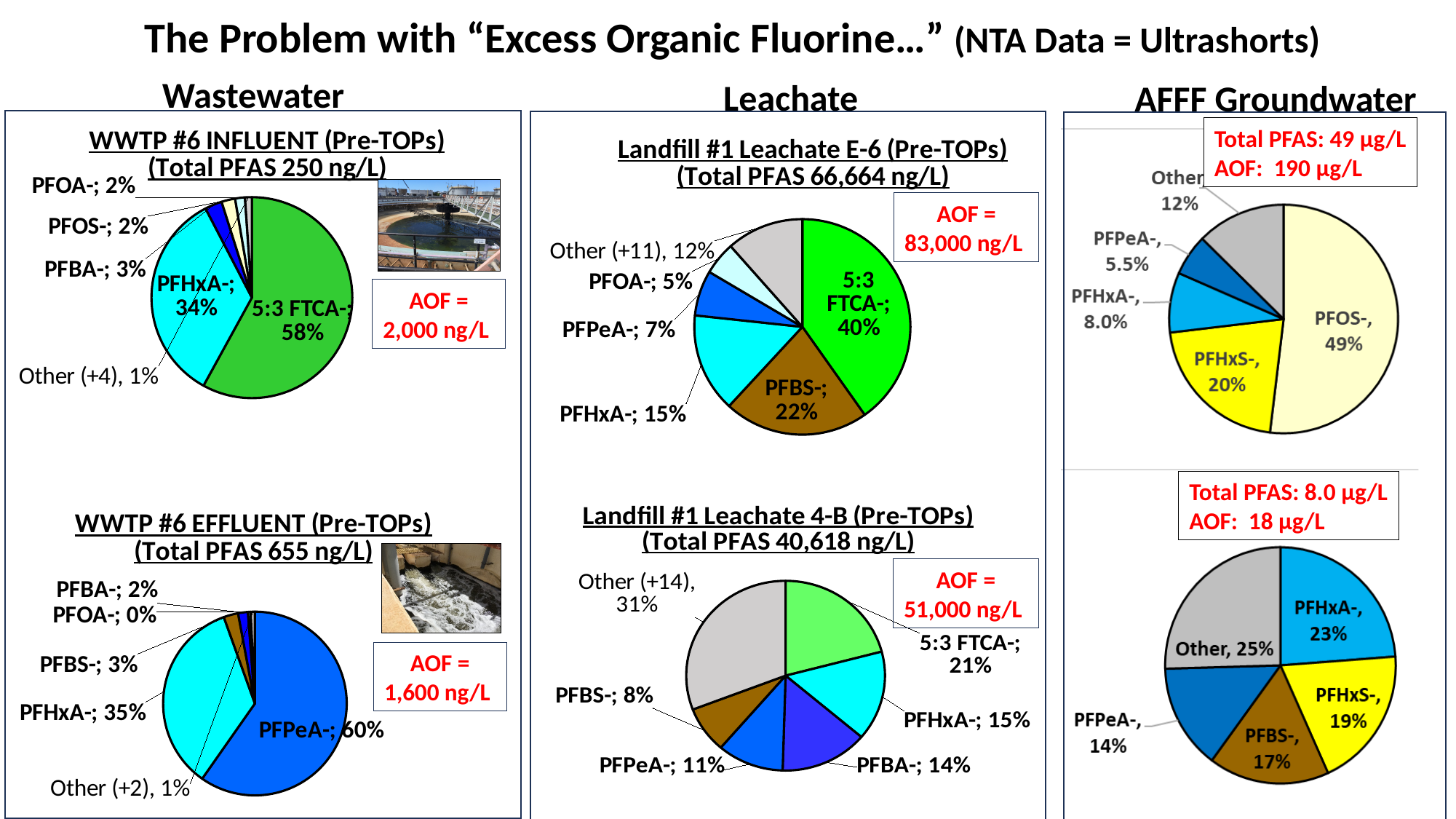
In the bottom AFFF Groundwater pie chart (Total PFAS: 8.0 µg/L), what share does PFHxS- have? 19% In the top AFFF Groundwater pie chart (Total PFAS: 49 µg/L), how many slices are there? 5 In the top AFFF Groundwater pie chart (Total PFAS: 49 µg/L), what share does PFOS- have? 49% In the WWTP #6 INFLUENT (Pre-TOPs) pie chart, what share does 5:3 FTCA- have? 58% In the Landfill #1 Leachate E-6 (Pre-TOPs) pie chart, which is larger, PFHxA- or PFPeA-? PFHxA- What kind of chart is used for the Landfill #1 Leachate E-6 (Pre-TOPs) data? Pie chart In the WWTP #6 EFFLUENT (Pre-TOPs) pie chart, what is the difference in percentage points between PFPeA- and PFHxA-? 25 In the WWTP #6 INFLUENT (Pre-TOPs) pie chart, which category has the largest slice? 5:3 FTCA- In the Landfill #1 Leachate 4-B (Pre-TOPs) pie chart, which labelled category has the smallest slice? PFBS-